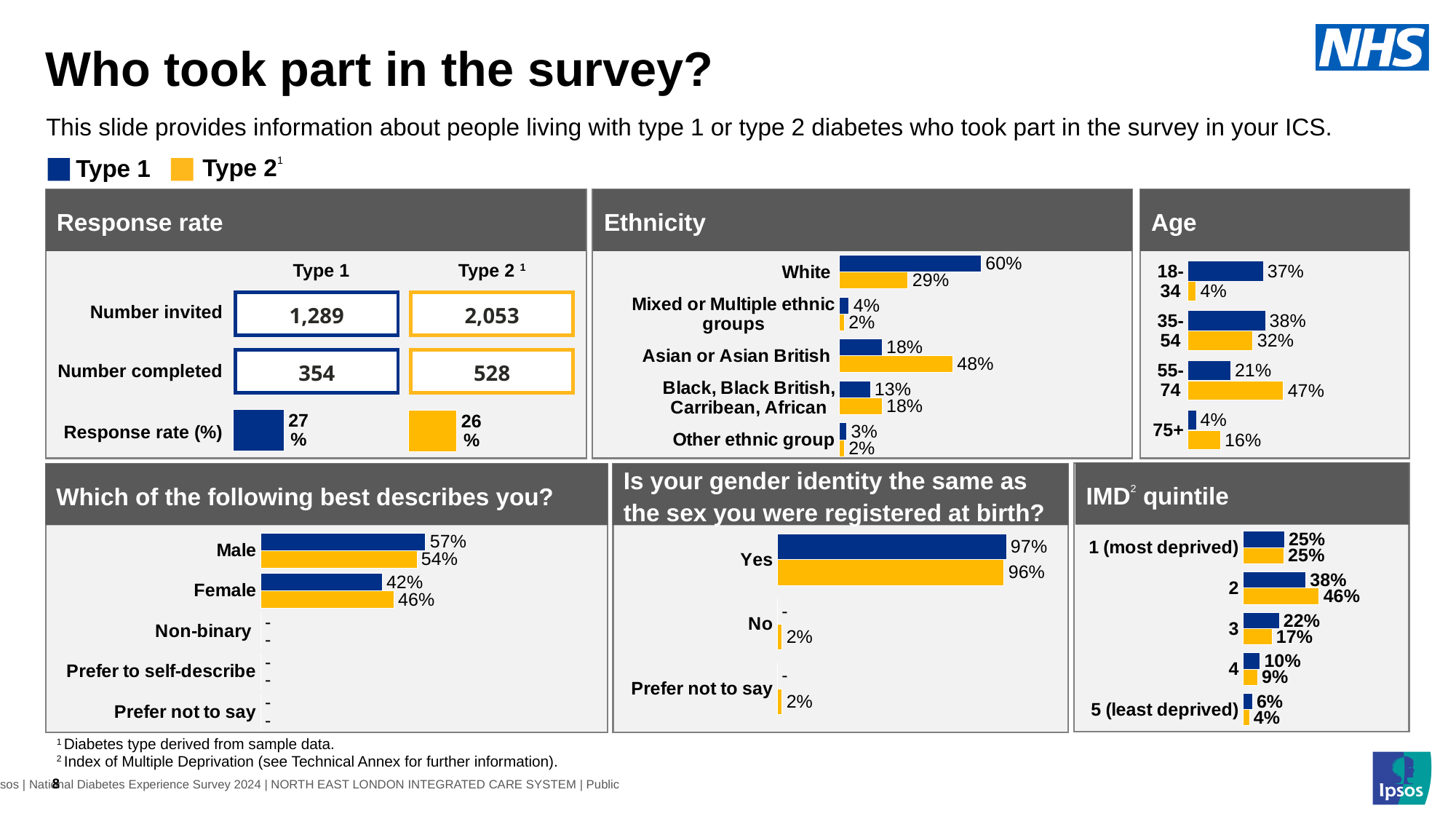
In the Age chart, what is the difference between the Type 1 and Type 2 values for the 75+ age group? 12% In the 'Which of the following best describes you?' chart, which is larger for Female: the Type 1 value or the Type 2 value? Type 2 In the Age chart, what is the Type 2 value for the 55-74 age group? 47% In the Response rate chart, what is the number completed for Type 2? 528 In the Age chart, which age group has the lowest Type 2 value? 18-34 How many series does the legend at the top of the slide list? 2 In the Ethnicity chart, what is the Type 2 value for Asian or Asian British? 48% In the gender identity chart, what is the Type 2 value for Yes? 96% In the IMD quintile chart, which quintile has the highest Type 2 value? 2 In the 'Which of the following best describes you?' chart, what is the Type 1 value for Male? 57% In the Ethnicity chart, which ethnic group has the highest Type 1 value? White In the IMD quintile chart, what is the difference between the Type 1 and Type 2 values for quintile 3? 5%